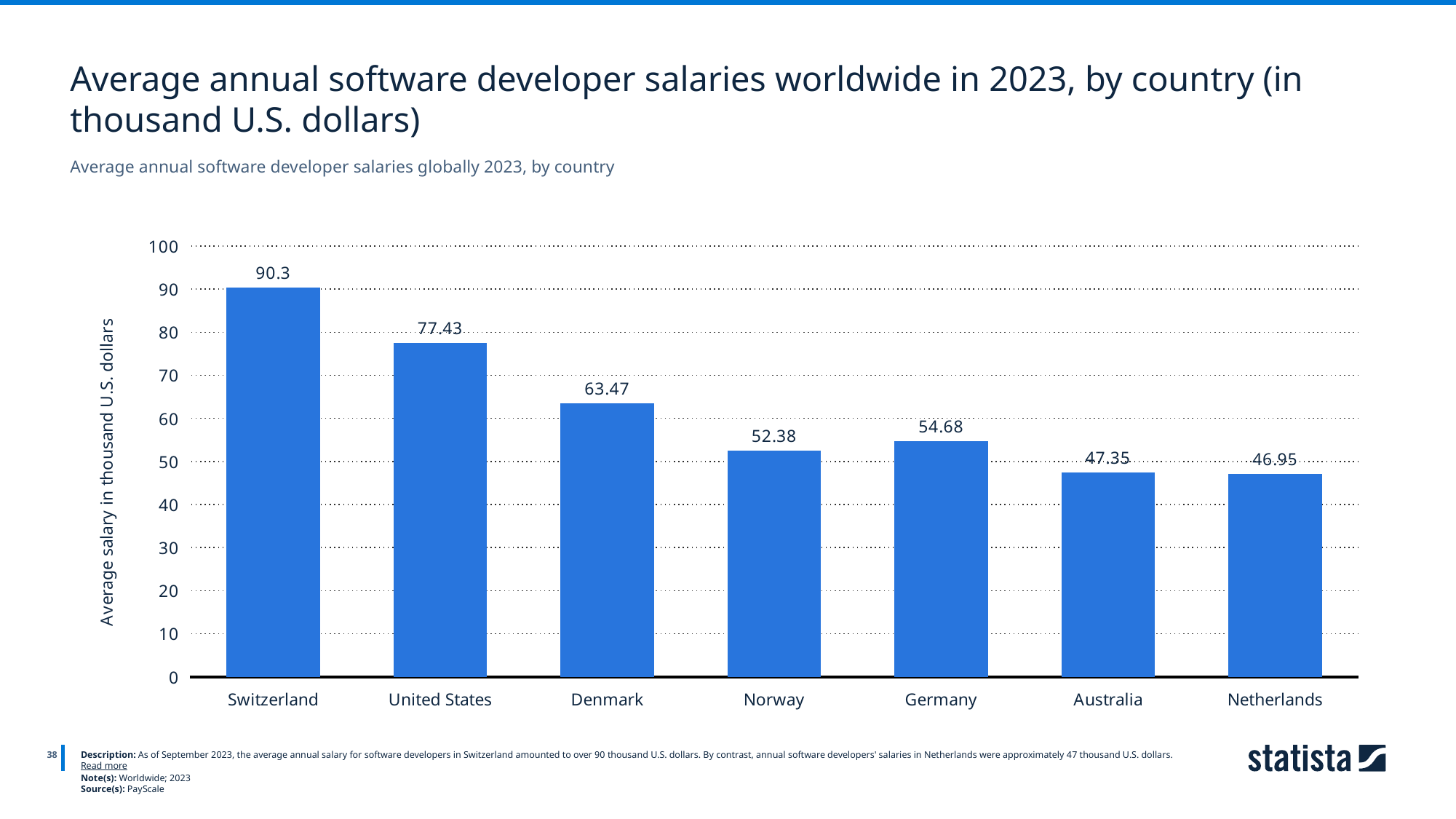
What is the difference between the average salary in Switzerland and the United States? 12.87 How many countries are shown in the chart? 7 Is the value for Denmark greater or less than 60? greater Which country has the highest average annual software developer salary? Switzerland Which country has the lowest average annual software developer salary? Netherlands Which country has a higher average salary, Norway or Germany? Germany What kind of chart is shown on the slide? Bar chart What is the difference between the average salary in Denmark and Norway? 11.09 What is the average annual software developer salary in the Netherlands? 46.95 What is the average annual software developer salary in Switzerland? 90.3 What is the average annual software developer salary in Germany? 54.68 What is the label of the vertical axis? Average salary in thousand U.S. dollars